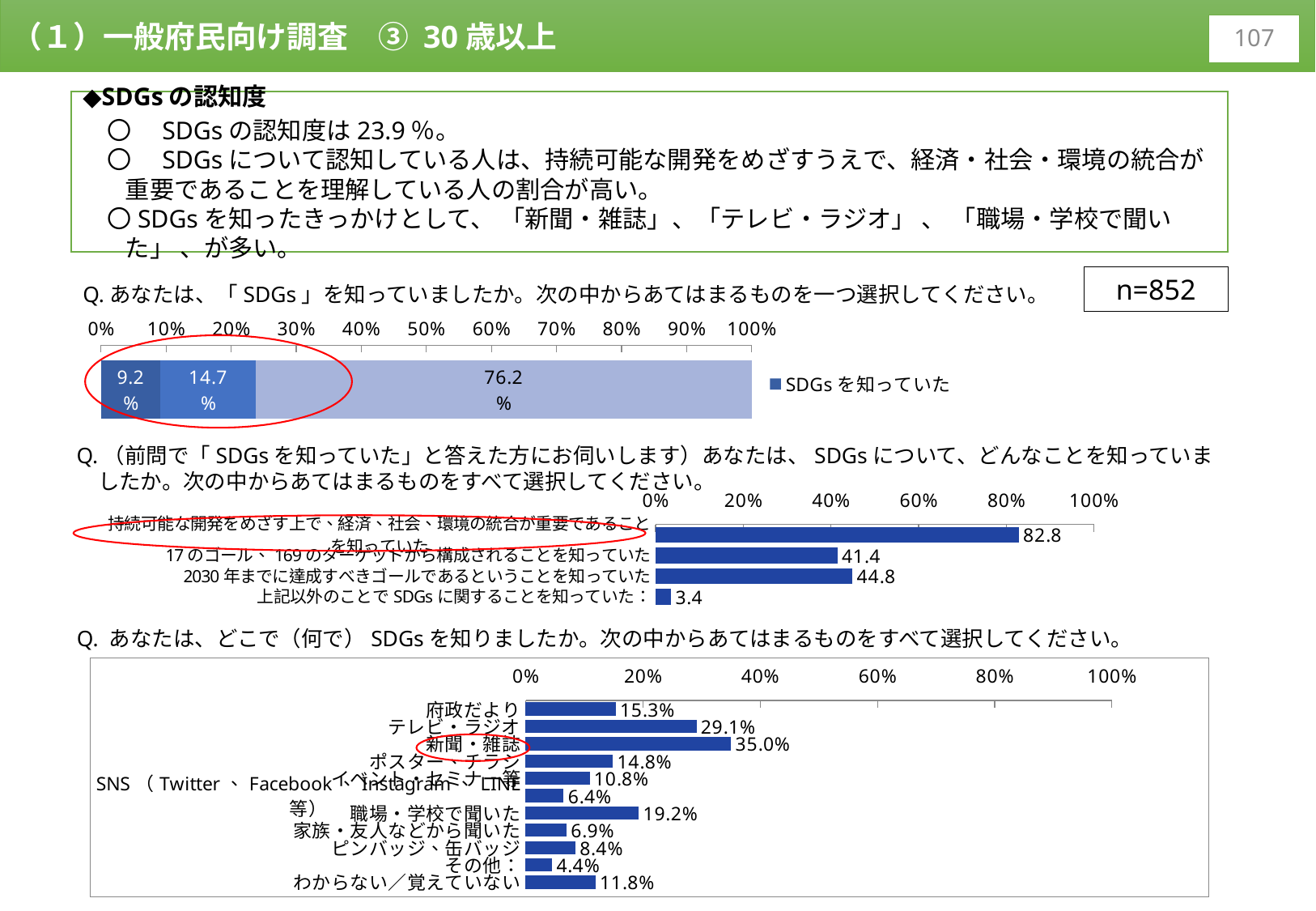
In the top stacked bar chart, what is the value of the largest (light blue) segment? 76.2% In the bottom chart (where people learned about SDGs), what is the value for 職場・学校で聞いた? 19.2% In the bottom chart (where people learned about SDGs), which category has the lowest value? その他 In the middle chart (what people knew about SDGs), what is the value for 2030年までに達成すべきゴールであるということを知っていた? 44.8 In the bottom chart (where people learned about SDGs), which category has the highest value? 新聞・雑誌 In the middle chart (what people knew about SDGs), which category has the highest value? 持続可能な開発をめざす上で、経済、社会、環境の統合が重要であることを知っていた In the bottom chart (where people learned about SDGs), what is the difference between 新聞・雑誌 and テレビ・ラジオ? 5.9% How many categories are shown in the bottom chart (where people learned about SDGs)? 11 In the middle chart (what people knew about SDGs), what is the difference between 82.8 and 41.4? 41.4 In the bottom chart (where people learned about SDGs), what is the value for 新聞・雑誌? 35.0% What type of chart is the bottom chart (where people learned about SDGs)? bar chart In the bottom chart (where people learned about SDGs), which is larger: 府政だより or ポスター・チラシ? 府政だより